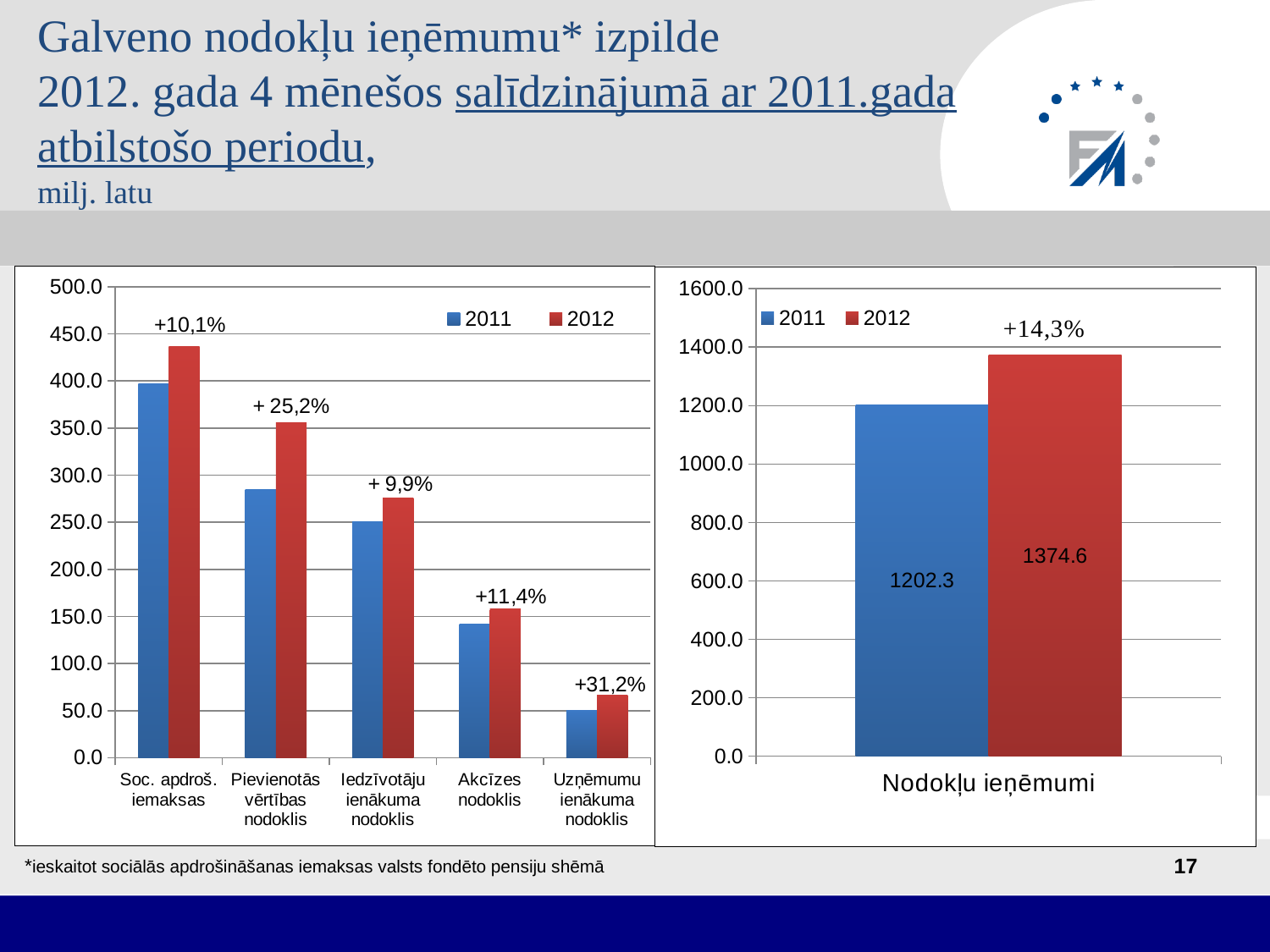
In the right chart (Nodokļu ieņēmumi), what is the value for 2012? 1374.6 In the right chart (Nodokļu ieņēmumi), what is the value for 2011? 1202.3 In the left chart, is the 2011 value for Iedzīvotāju ienākuma nodoklis greater or less than 200.0? greater In the left chart, which category has the highest 2012 value? Soc. apdroš. iemaksas In the left chart, how many series does the legend list? 2 In the left chart, is the 2012 value for Pievienotās vērtības nodoklis greater or less than 300.0? greater In the right chart (Nodokļu ieņēmumi), what percentage change label is shown above the bars? +14,3% What kind of chart is the left chart? bar chart In the left chart, which category has the lowest 2011 value? Uzņēmumu ienākuma nodoklis In the right chart (Nodokļu ieņēmumi), what is the difference between the 2012 and 2011 values? 172.3 In the left chart, how many tax categories are shown on the x axis? 5 In the left chart, what percentage change label is shown for Uzņēmumu ienākuma nodoklis? +31,2%